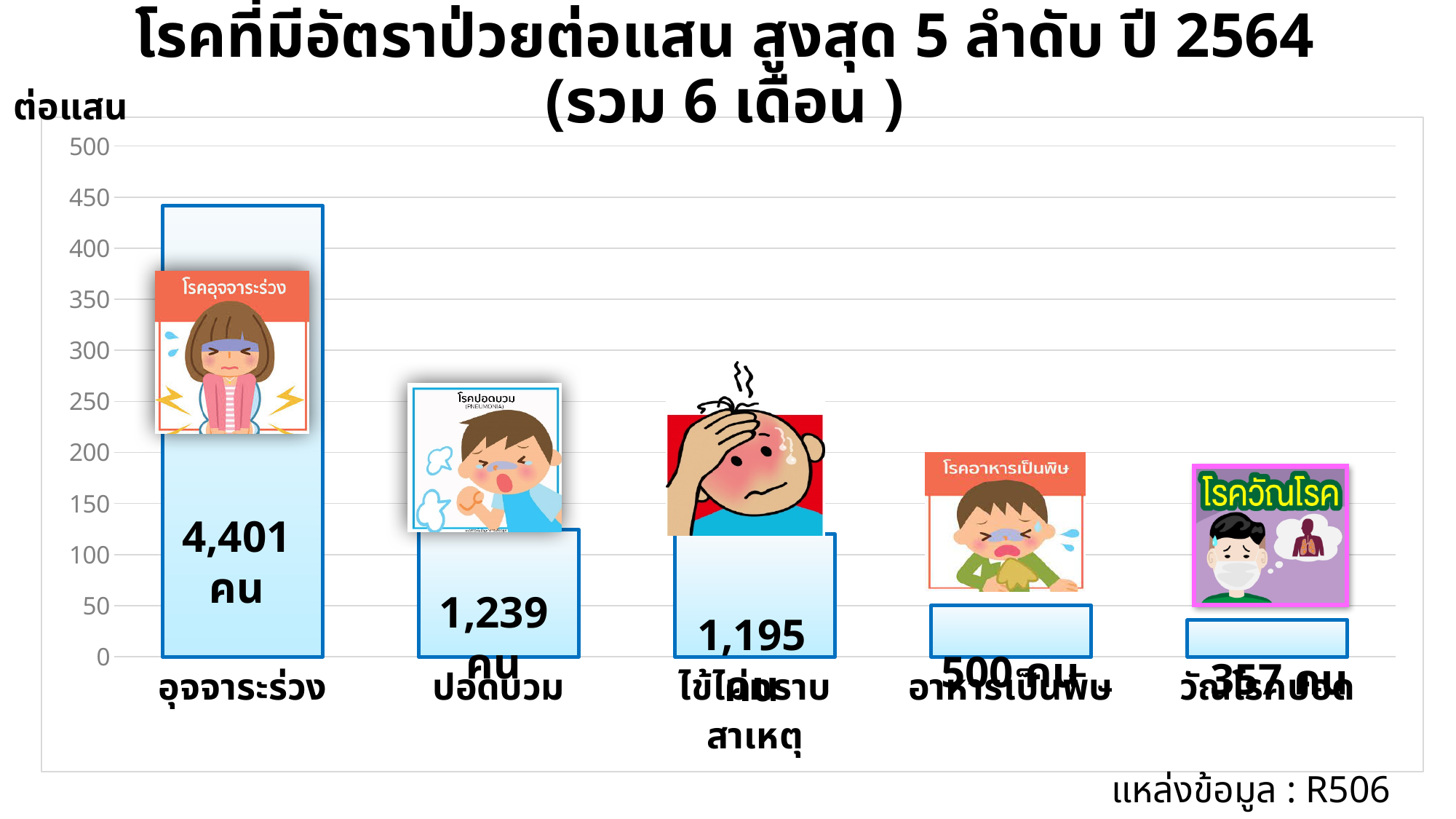
What number of cases is printed for ไข้ไม่ทราบสาเหตุ? 1,195 คน Is the bar for อุจจาระร่วง greater or less than 400 on the axis? greater What data source is cited at the bottom of the slide? R506 Which disease has the lowest bar in the chart? วัณโรคปอด How many diseases (categories) are plotted in the chart? 5 What kind of chart is shown on the slide? bar chart What number of cases is printed for วัณโรคปอด? 357 คน What number of cases is printed for ปอดบวม? 1,239 คน What number of cases is printed for อาหารเป็นพิษ? 500 คน Is the bar for วัณโรคปอด greater or less than 50 on the axis? less Which disease has the highest bar in the chart? อุจจาระร่วง What number of cases is printed for อุจจาระร่วง? 4,401 คน